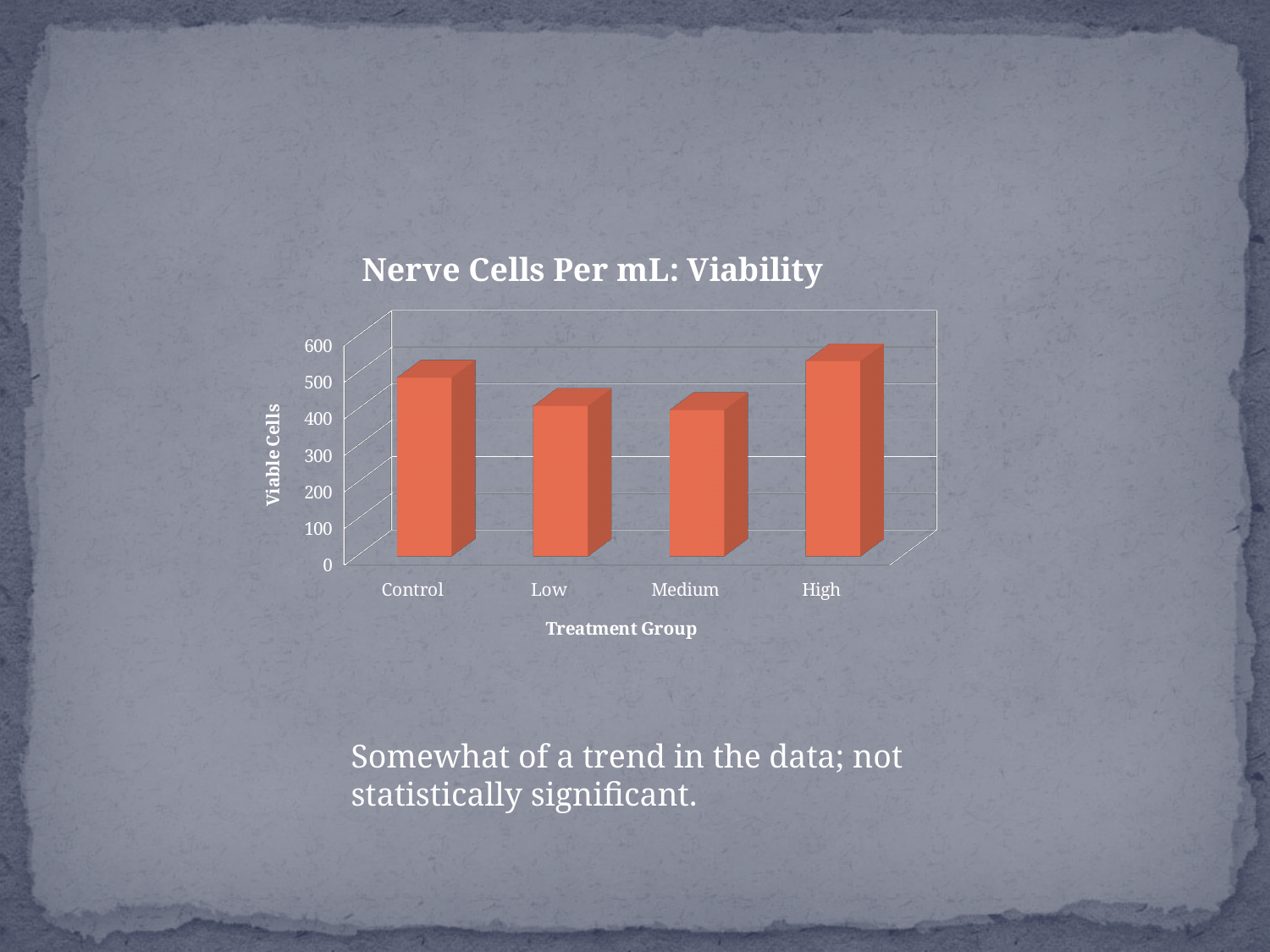
Is the value for Medium greater or less than 500? less Is the value for High greater or less than 600? less What kind of chart is shown on the slide? bar chart Which is larger, the value for Control or the value for Low? Control Which treatment group has the highest number of viable cells? High Is the value for Medium greater or less than 300? greater What is the label of the vertical axis? Viable Cells What is the title of the chart? Nerve Cells Per mL: Viability Which is larger, the value for High or the value for Medium? High How many treatment groups are plotted on the x axis? 4